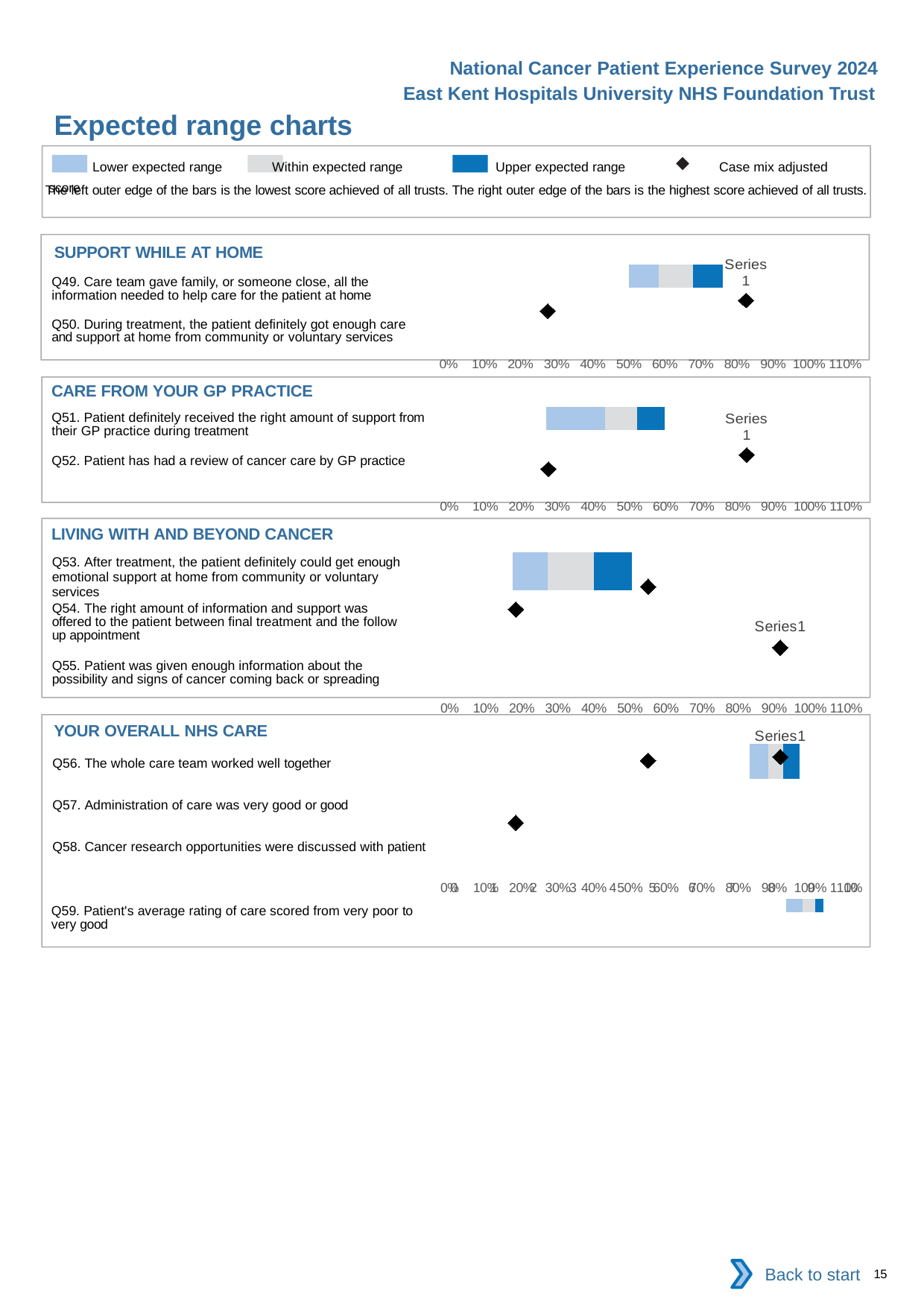
How many questions are listed in the LIVING WITH AND BEYOND CANCER chart? 3 What is the highest percentage label shown on the x axis of the CARE FROM YOUR GP PRACTICE chart? 110% In the CARE FROM YOUR GP PRACTICE chart, is the right edge of the expected range bar greater or less than 70%? less What is the title of the slide containing the charts? Expected range charts How many questions are listed in the SUPPORT WHILE AT HOME chart? 2 How many entries does the legend at the top of the slide list? 4 How many questions are listed in the YOUR OVERALL NHS CARE chart? 4 In the SUPPORT WHILE AT HOME chart, is the right edge of the expected range bar greater or less than 90%? less In the legend, which colour represents the Upper expected range? dark blue What kind of chart is used in the SUPPORT WHILE AT HOME section? bar chart In the LIVING WITH AND BEYOND CANCER chart, is the left edge of the expected range bar greater or less than 10%? greater